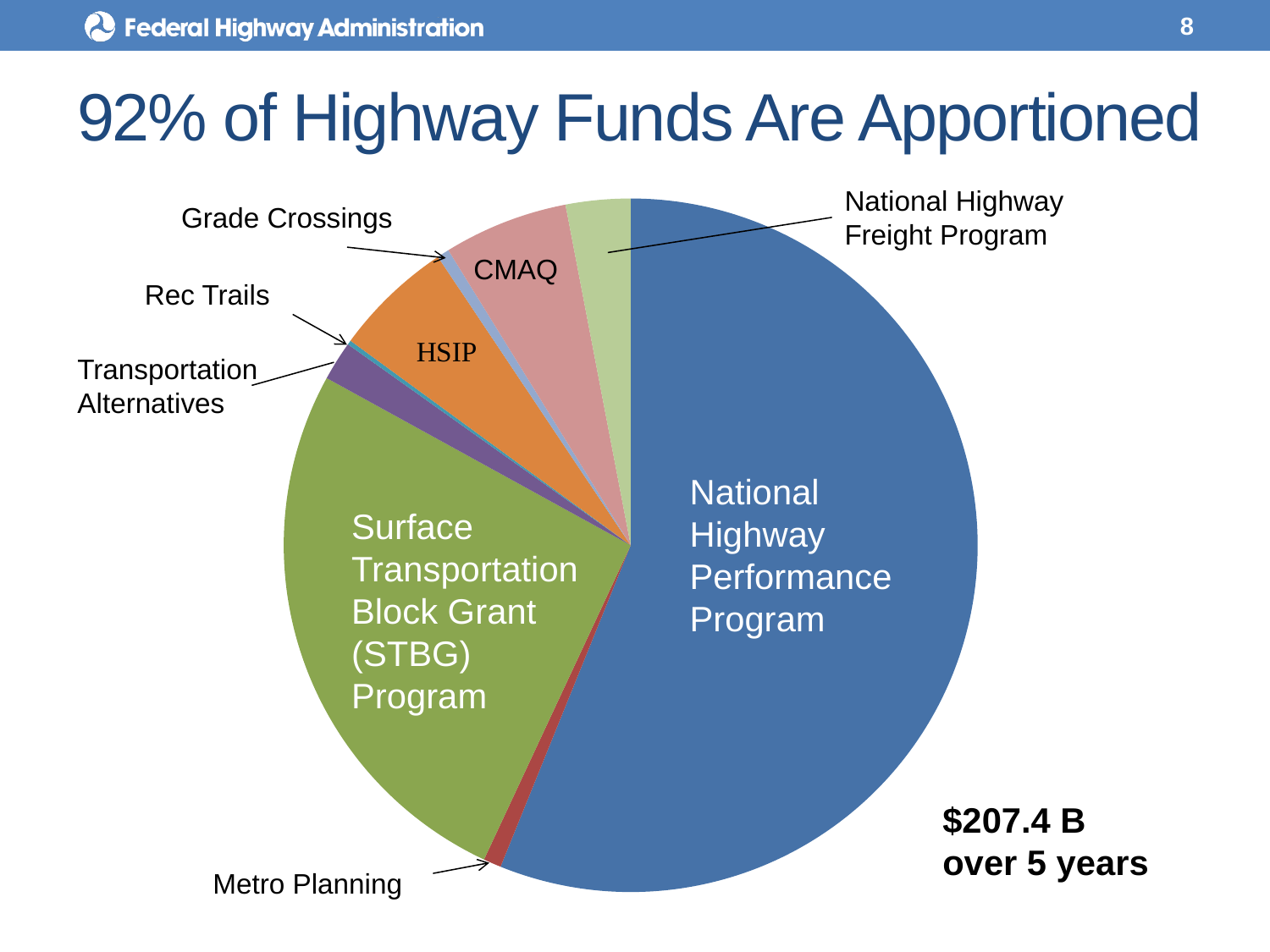
Which slice is larger: CMAQ or Metro Planning? CMAQ How many slices (programs) does the pie chart show? 9 What total amount is stated next to the pie chart? $207.4 B over 5 years Which slice is larger: Surface Transportation Block Grant (STBG) Program or HSIP? Surface Transportation Block Grant (STBG) Program Which slice is larger: HSIP or Transportation Alternatives? HSIP What is the title of the slide containing the pie chart? 92% of Highway Funds Are Apportioned Which program has the largest slice of the pie chart? National Highway Performance Program What kind of chart is shown on the slide? Pie chart